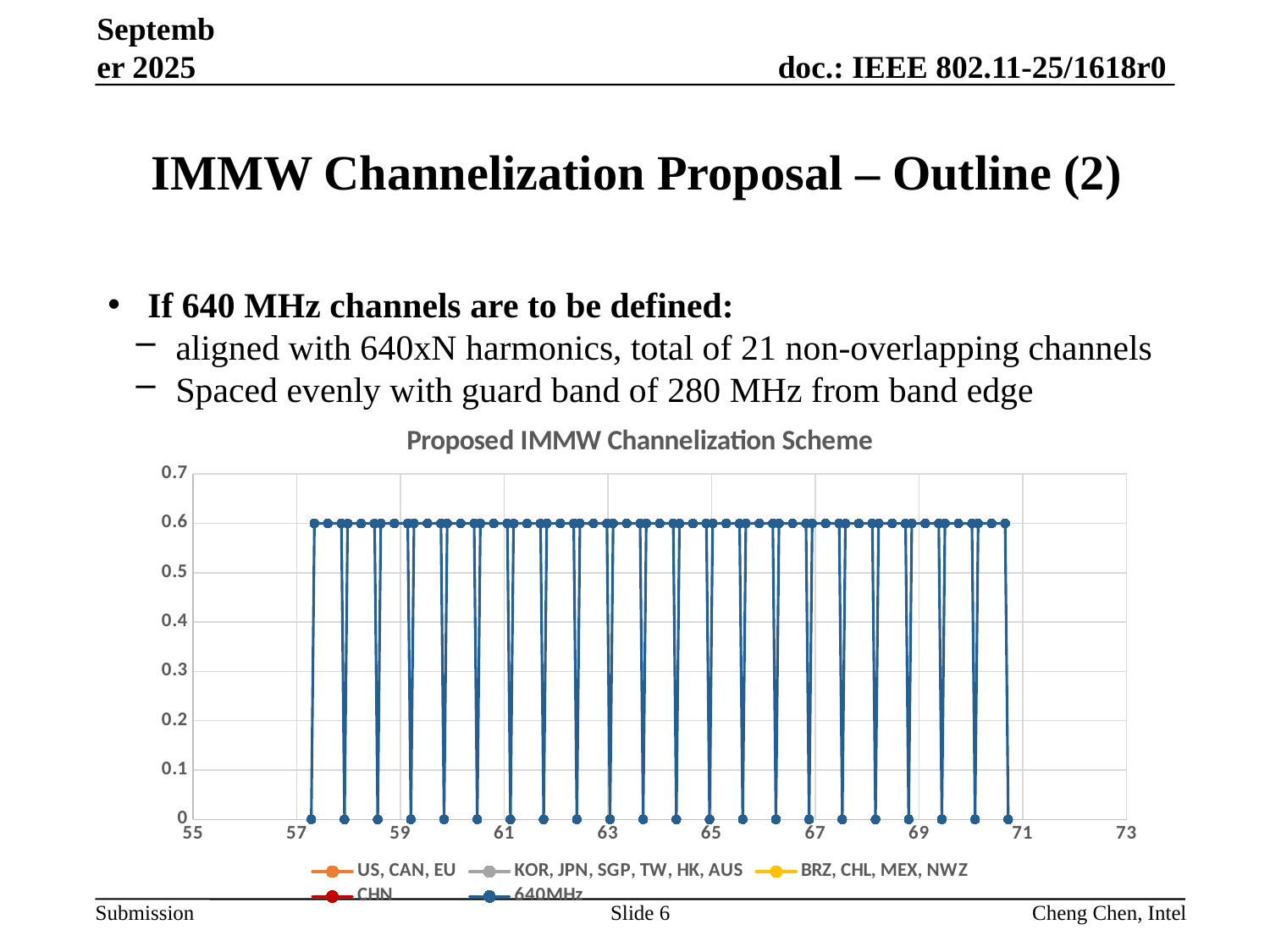
What is the highest value shown on the chart's vertical axis? 0.7 What is the largest value labelled on the chart's horizontal axis? 73 How many separate channel blocks (pulses) does the 640MHz series show on the chart? 21 What is the smallest value labelled on the chart's horizontal axis? 55 What is the lowest value reached by the 640MHz series between channel blocks? 0 What kind of chart is shown on the slide? line chart At what level on the vertical axis do the peaks of the 640MHz series sit? 0.6 Is the peak value of the 640MHz series greater or less than 0.7? less How many series does the chart's legend list? 5 Is the peak value of the 640MHz series greater or less than 0.5? greater